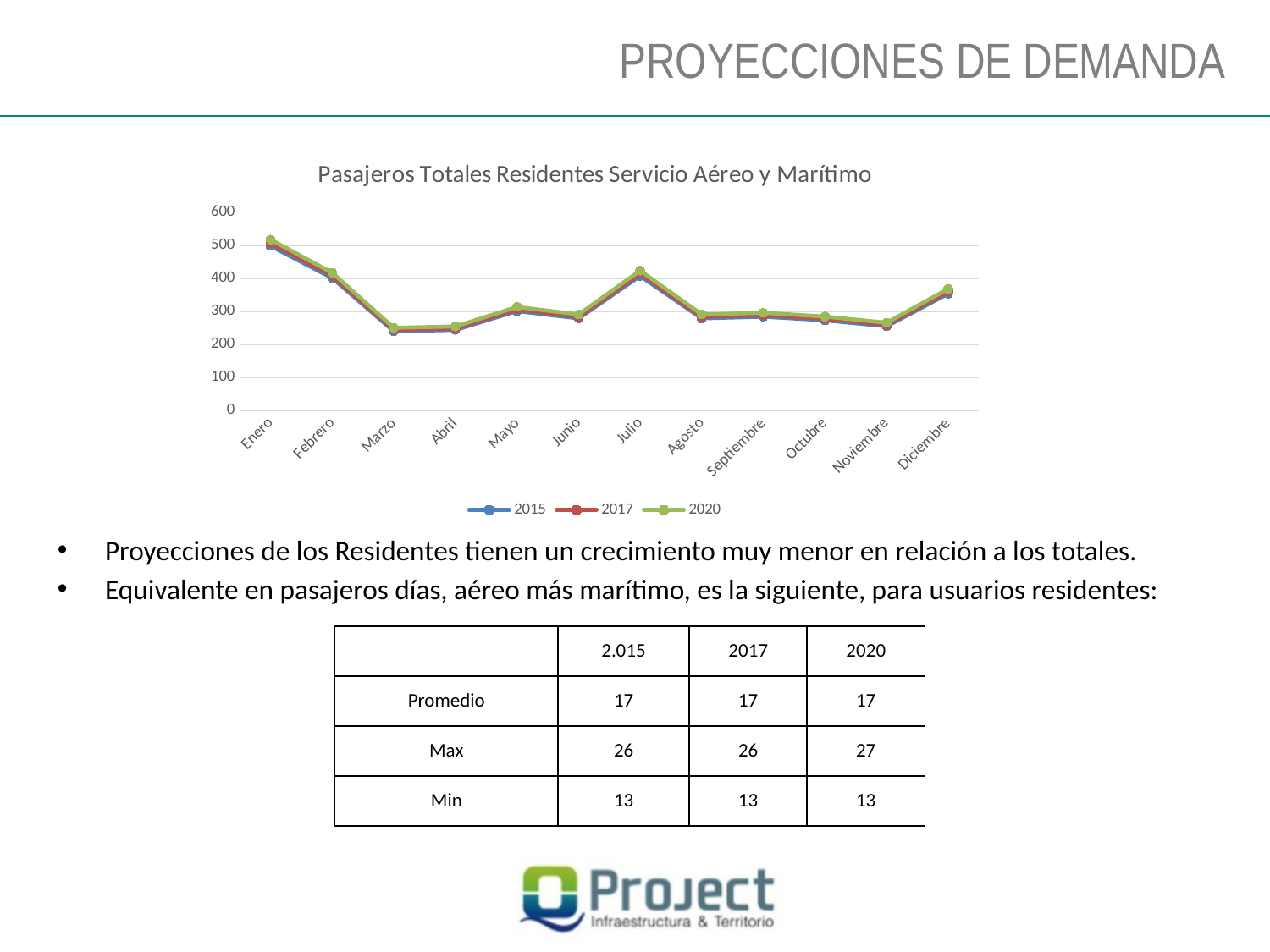
How many series does the chart legend list? 3 Which month has the larger value in the 2020 series, Enero or Julio? Enero Is the value for Noviembre in the 2015 series greater or less than 300? less Which month has the highest value in the chart? Enero Do the values rise or fall from Enero to Marzo? fall Is the value for Julio in the 2017 series greater or less than 300? greater Is the value for Enero in the 2015 series greater or less than 400? greater Which series is drawn in green in the chart? 2020 How many months are plotted along the x axis of the chart? 12 What is the title of the chart? Pasajeros Totales Residentes Servicio Aéreo y Marítimo What kind of chart is shown on the slide? line chart